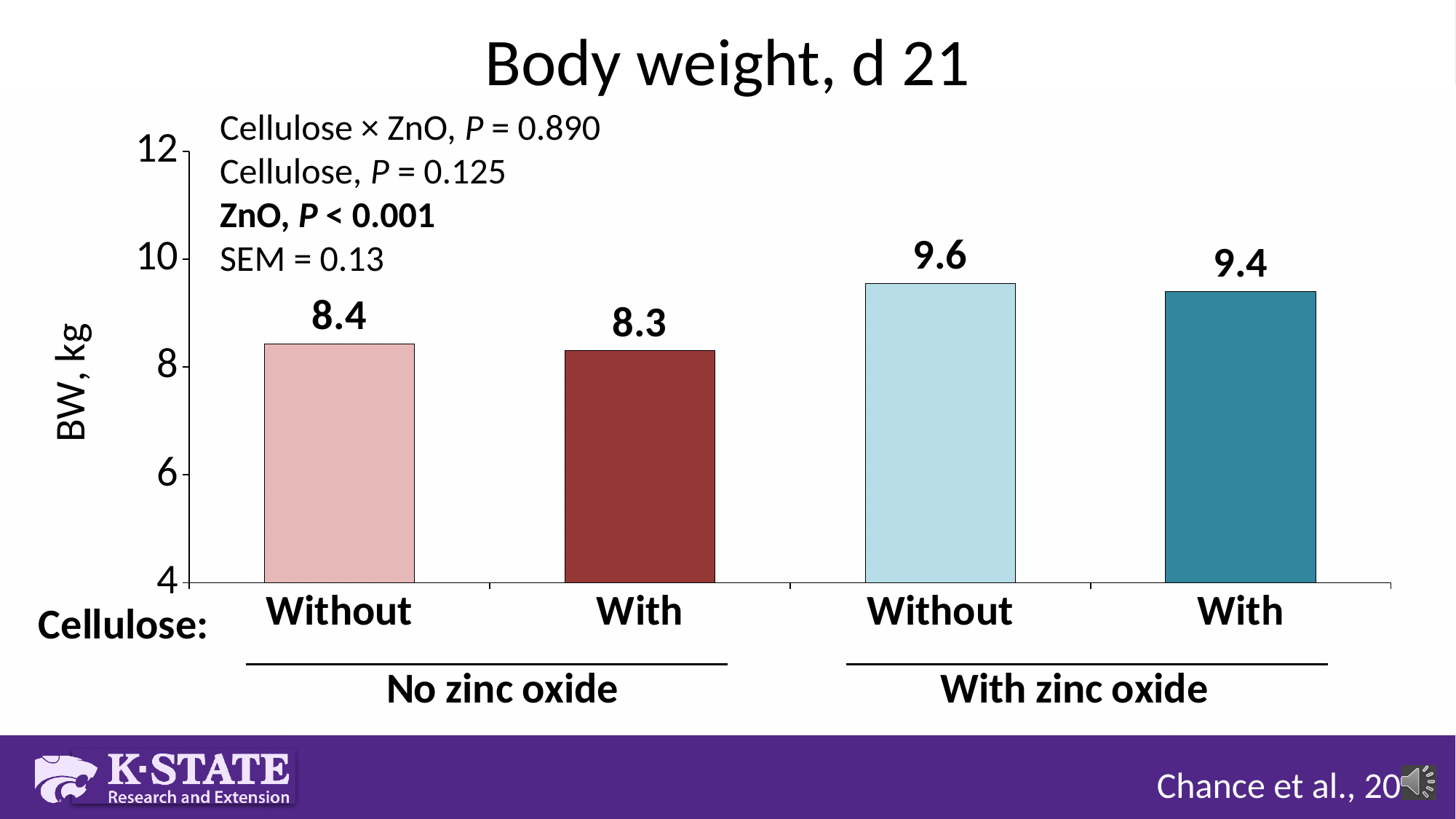
What is the body weight for the 'Without' cellulose group with zinc oxide? 9.6 Which bar has the highest body weight? Without cellulose, with zinc oxide What is the body weight for the 'Without' cellulose group with no zinc oxide? 8.4 Is the value for the 'With' cellulose bar under no zinc oxide greater or less than 10? less What is the body weight for the 'With' cellulose group with zinc oxide? 9.4 Which is larger: the 'With' cellulose bar under no zinc oxide or the 'With' cellulose bar under with zinc oxide? With zinc oxide What is the difference in body weight between the 'Without' cellulose bars with and without zinc oxide? 1.2 What is the y-axis label of the chart? BW, kg What kind of chart is shown on the slide? Bar chart Which bar has the lowest body weight? With cellulose, no zinc oxide How many bars are shown in the chart? 4 What is the title of the chart? Body weight, d 21